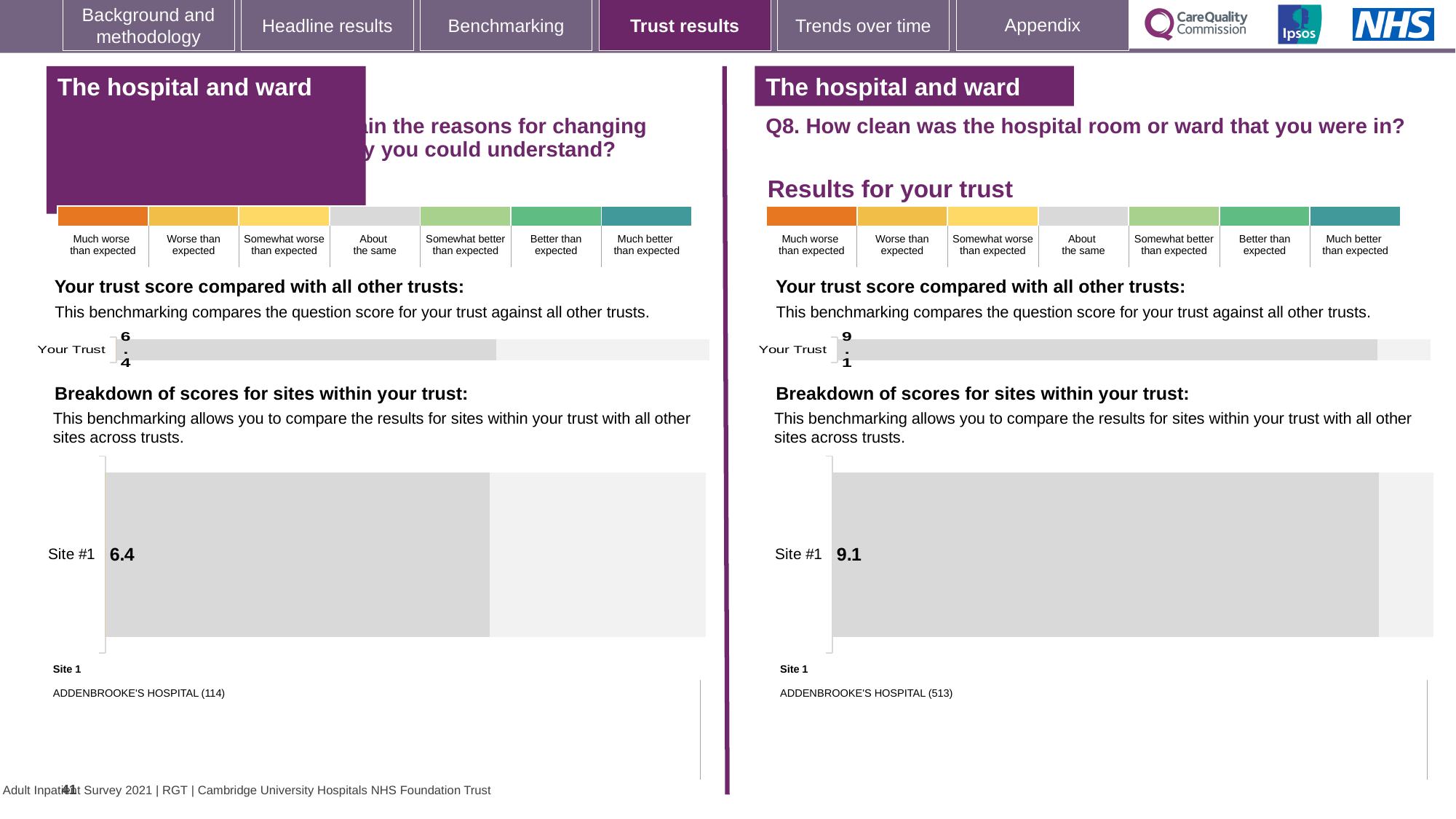
On the right half of the slide (Q8, how clean was the hospital room or ward), in the 'Your trust score compared with all other trusts' chart, what is the value for Your Trust? 9.1 On the left half of the slide, in the 'Your trust score compared with all other trusts' chart, what is the value for Your Trust? 6.4 In the breakdown chart on the left half of the slide, which site name is listed as Site 1? ADDENBROOKE'S HOSPITAL (114) Which is larger: the Site #1 score in the left-hand breakdown chart or the Site #1 score in the right-hand (Q8) breakdown chart? Right-hand (Q8) chart How many sites are shown in the 'Breakdown of scores for sites within your trust' chart on the right half of the slide (Q8)? 1 How many sites are shown in the 'Breakdown of scores for sites within your trust' chart on the left half of the slide? 1 On the right half of the slide (Q8, how clean was the hospital room or ward), in the 'Breakdown of scores for sites within your trust' chart, what is the value for Site #1? 9.1 In the breakdown chart on the right half of the slide (Q8), which site name is listed as Site 1? ADDENBROOKE'S HOSPITAL (513) What is the difference between the Your Trust score on the right half (Q8) and the Your Trust score on the left half of the slide? 2.7 What type of chart is used to show the Site #1 score in the breakdown chart on the right half of the slide (Q8)? Bar chart On the left half of the slide, in the 'Breakdown of scores for sites within your trust' chart, what is the value for Site #1? 6.4